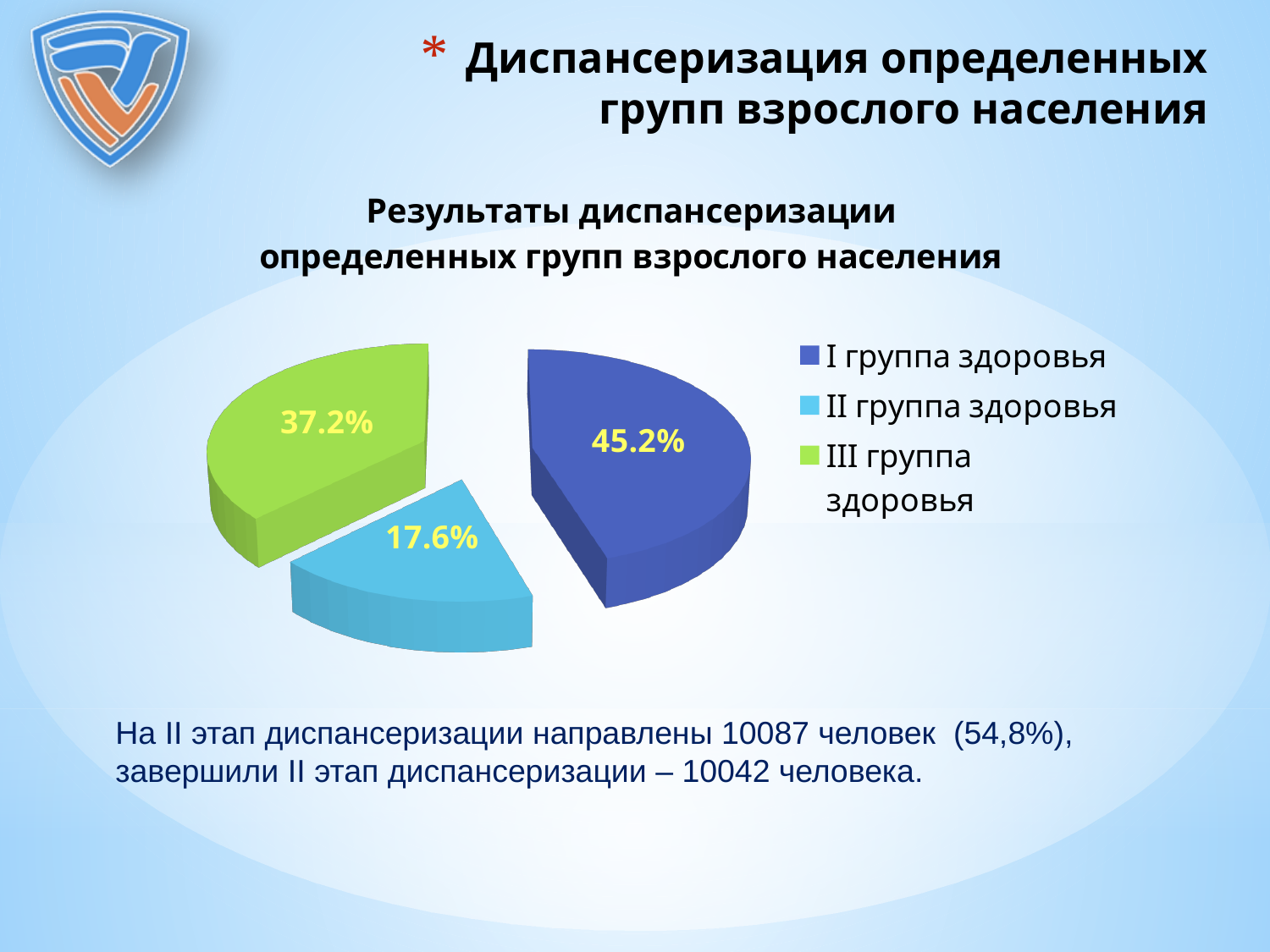
What is the difference in percentage points between I группа здоровья and III группа здоровья? 8.0% What share of the pie does I группа здоровья have? 45.2% What share of the pie does II группа здоровья have? 17.6% Which health group has the largest share of the pie? I группа здоровья What kind of chart is shown on the slide? Pie chart How many entries does the legend list? 3 What is the difference in percentage points between III группа здоровья and II группа здоровья? 19.6% Which health group has the smallest share of the pie? II группа здоровья What colour is the slice for III группа здоровья? Green What share of the pie does III группа здоровья have? 37.2% Which is larger: the share for II группа здоровья or III группа здоровья? III группа здоровья How many slices does the pie chart have? 3